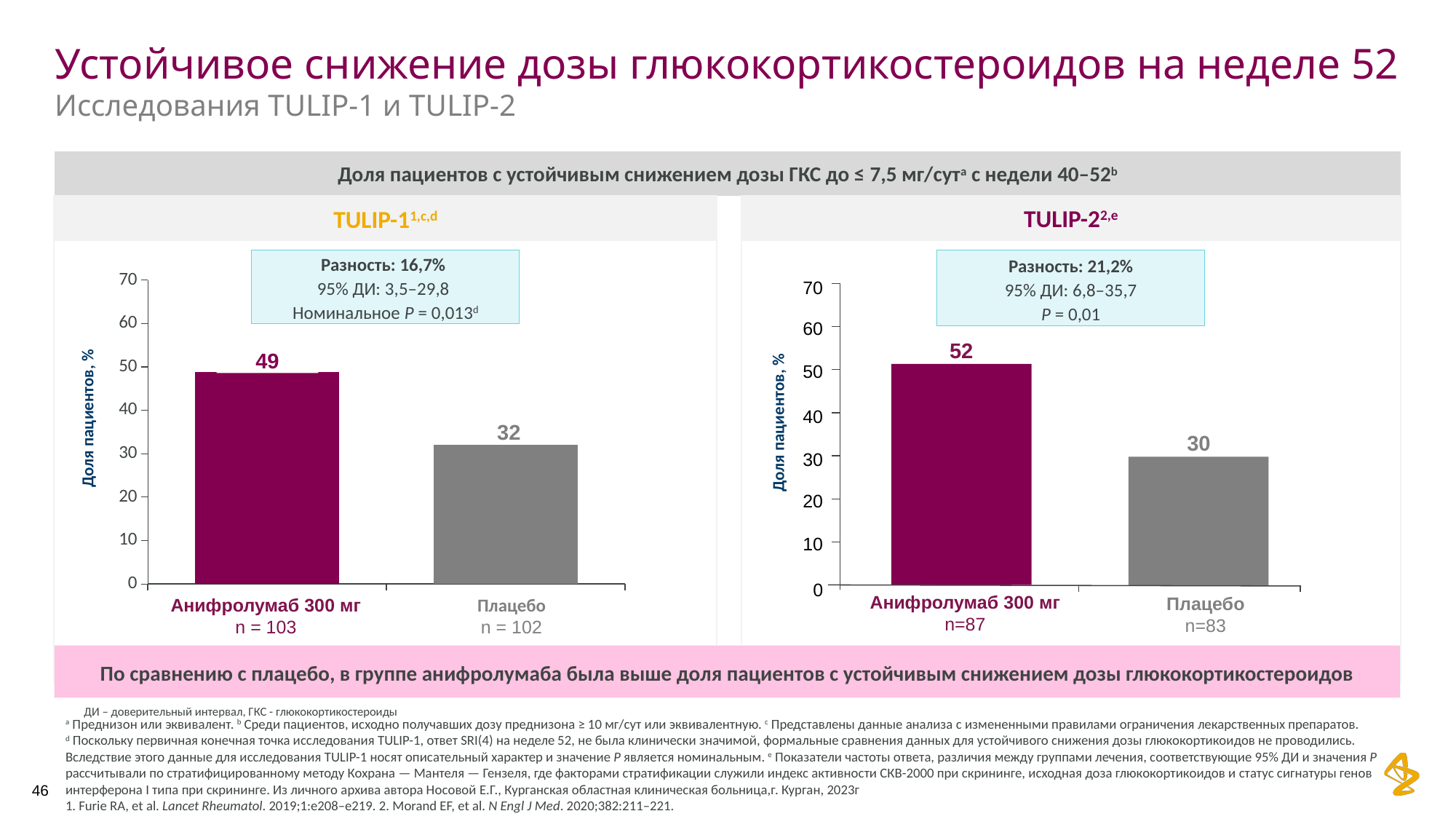
In the TULIP-2 chart, which group has the lowest value? Плацебо In the TULIP-2 chart, which is larger: the value for Анифролумаб 300 мг or for Плацебо? Анифролумаб 300 мг What kind of chart is the TULIP-1 chart? bar chart How many bars are shown in the TULIP-2 chart? 2 In the TULIP-2 chart, what is the difference between the Анифролумаб 300 мг and Плацебо values? 22 In the TULIP-1 chart, which group has the highest value? Анифролумаб 300 мг In the TULIP-1 chart, what is the value for Плацебо? 32 In the TULIP-2 chart, what is the value for Анифролумаб 300 мг? 52 In the TULIP-2 chart, what is the value for Плацебо? 30 In the TULIP-1 chart, what is the difference between the Анифролумаб 300 мг and Плацебо values? 17 In the TULIP-1 chart, what is the value for Анифролумаб 300 мг? 49 In the TULIP-1 chart, is the value for Плацебо greater or less than 40? less